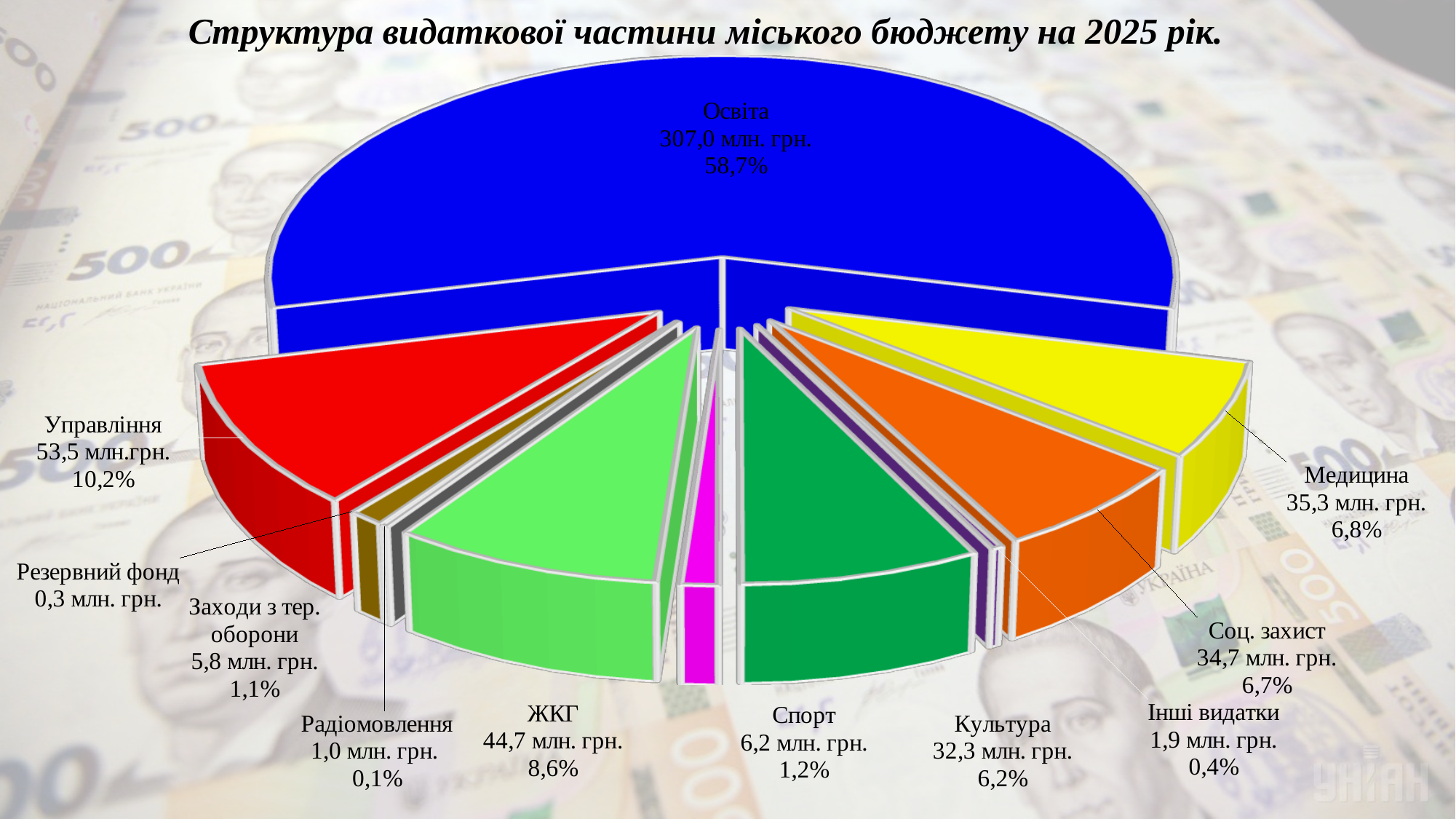
Which category has the smallest value? Резервний фонд What is the value for Освіта? 307,0 млн. грн. What share of the pie does Медицина take? 6,8% What is the difference between the values for Освіта and Управління? 253,5 млн. грн. Which is larger, the value for Медицина or the value for Соц. захист? Медицина Which category has the largest value? Освіта What is the value for Заходи з тер. оборони? 5,8 млн. грн. How many categories does the pie chart show? 11 What is the title of the chart? Структура видаткової частини міського бюджету на 2025 рік. What is the value for ЖКГ? 44,7 млн. грн. What share of the pie does Освіта take? 58,7% What kind of chart is shown on the slide? pie chart